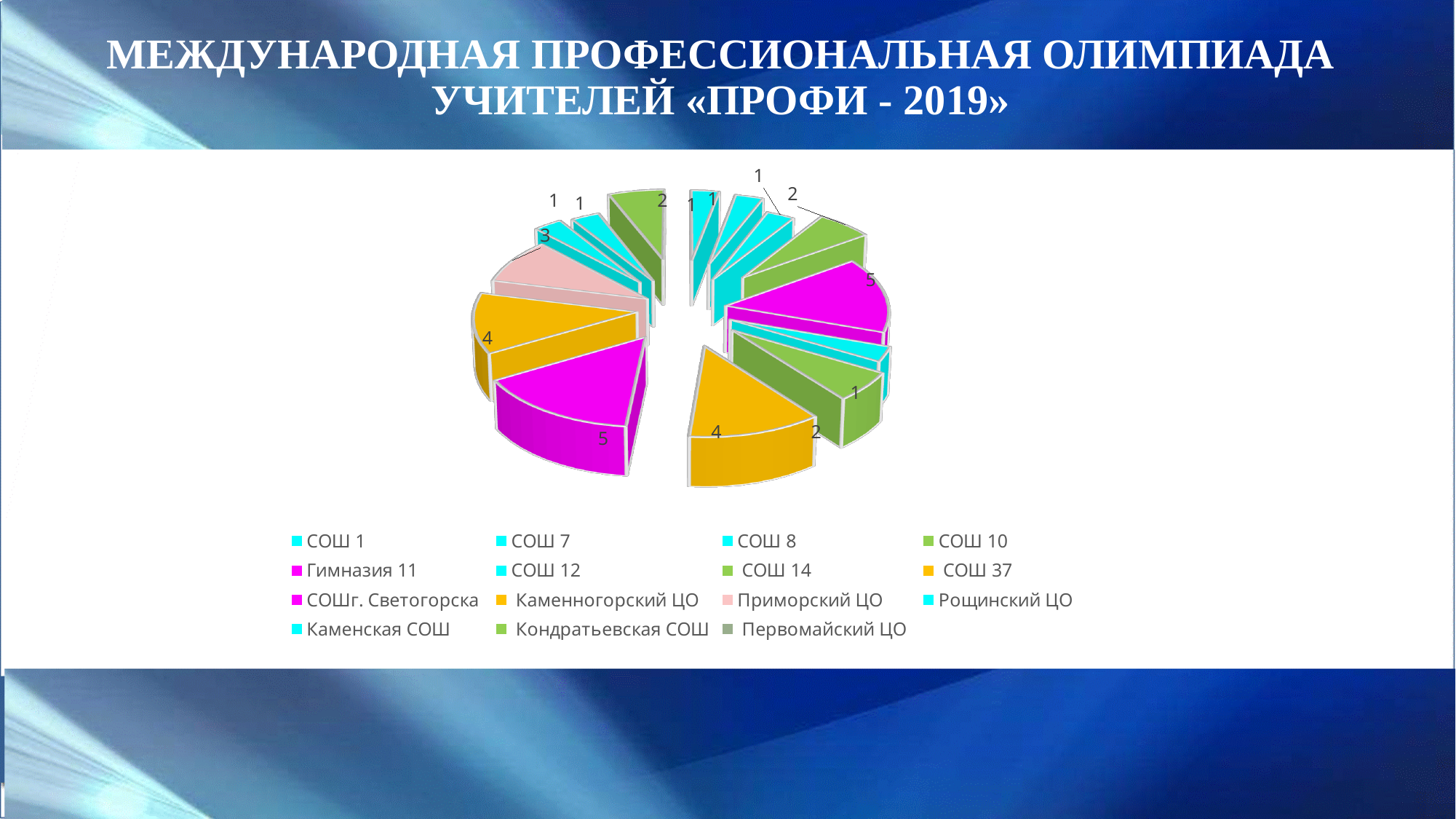
What colour is the slice for Приморский ЦО in the legend? pink What is the largest value printed on any slice of the pie chart? 5 What is the smallest value printed on any slice of the pie chart? 1 Which is larger, the value for Приморский ЦО or the value for Гимназия 11? Гимназия 11 What is the difference between the value for Гимназия 11 and the value for Приморский ЦО? 2 What is the title of the slide containing the pie chart? МЕЖДУНАРОДНАЯ ПРОФЕССИОНАЛЬНАЯ ОЛИМПИАДА УЧИТЕЛЕЙ «ПРОФИ - 2019» What kind of chart is shown on the slide? pie chart What is the value shown for Приморский ЦО? 3 How many entries does the legend of the pie chart list? 15